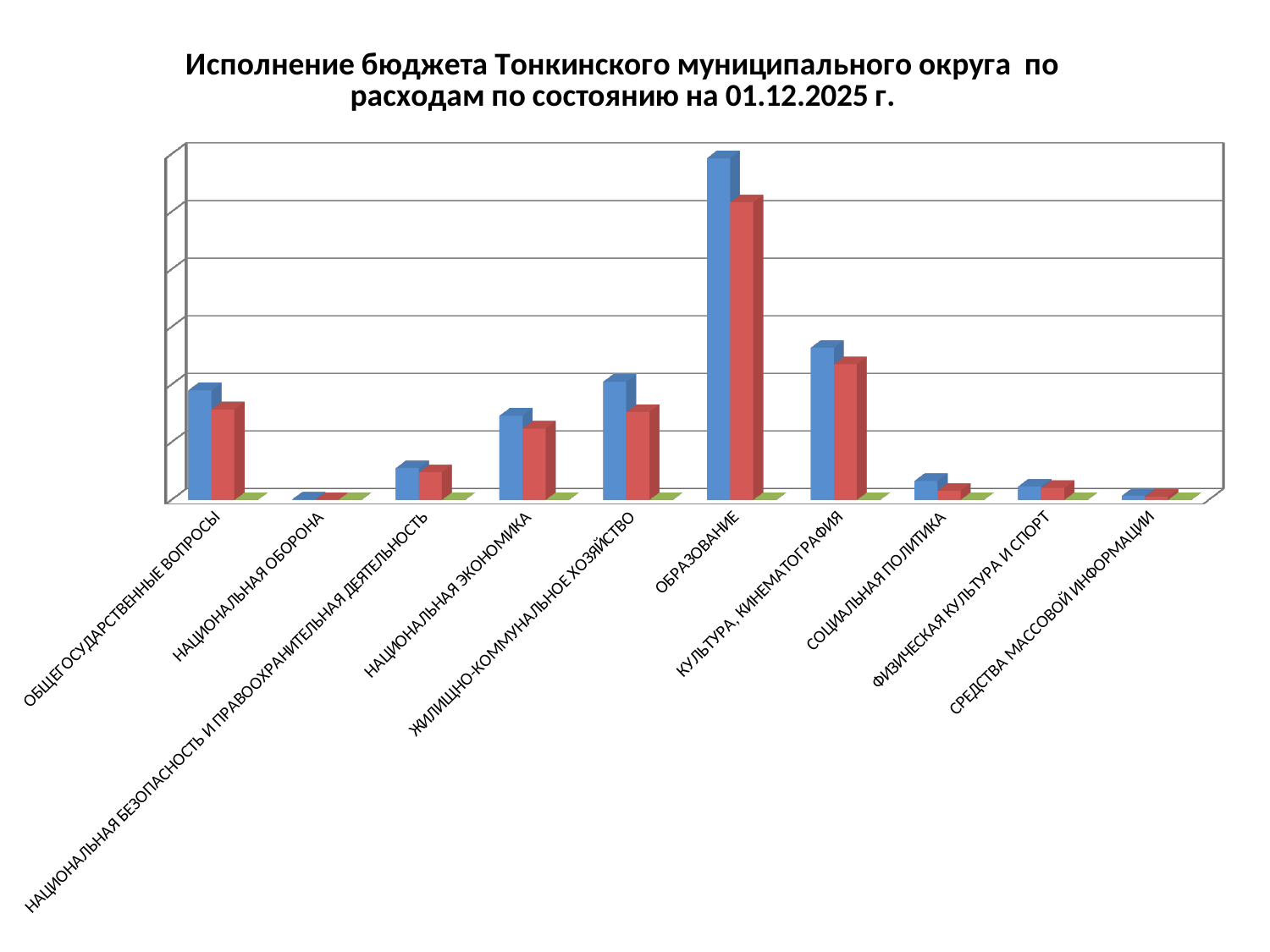
Which category has the highest bars in the chart? ОБРАЗОВАНИЕ Which category has higher bars: ЖИЛИЩНО-КОММУНАЛЬНОЕ ХОЗЯЙСТВО or НАЦИОНАЛЬНАЯ ЭКОНОМИКА? ЖИЛИЩНО-КОММУНАЛЬНОЕ ХОЗЯЙСТВО Which category has the second-highest bars in the chart? КУЛЬТУРА, КИНЕМАТОГРАФИЯ How many categories are shown along the x axis of the chart? 10 What colour is the tallest bar in the chart? blue What is the title of the chart? Исполнение бюджета Тонкинского муниципального округа по расходам по состоянию на 01.12.2025 г. Which category has higher bars: ОБРАЗОВАНИЕ or КУЛЬТУРА, КИНЕМАТОГРАФИЯ? ОБРАЗОВАНИЕ For the category КУЛЬТУРА, КИНЕМАТОГРАФИЯ, which bar is taller: the blue one or the red one? the blue one What kind of chart is shown on the slide? bar chart